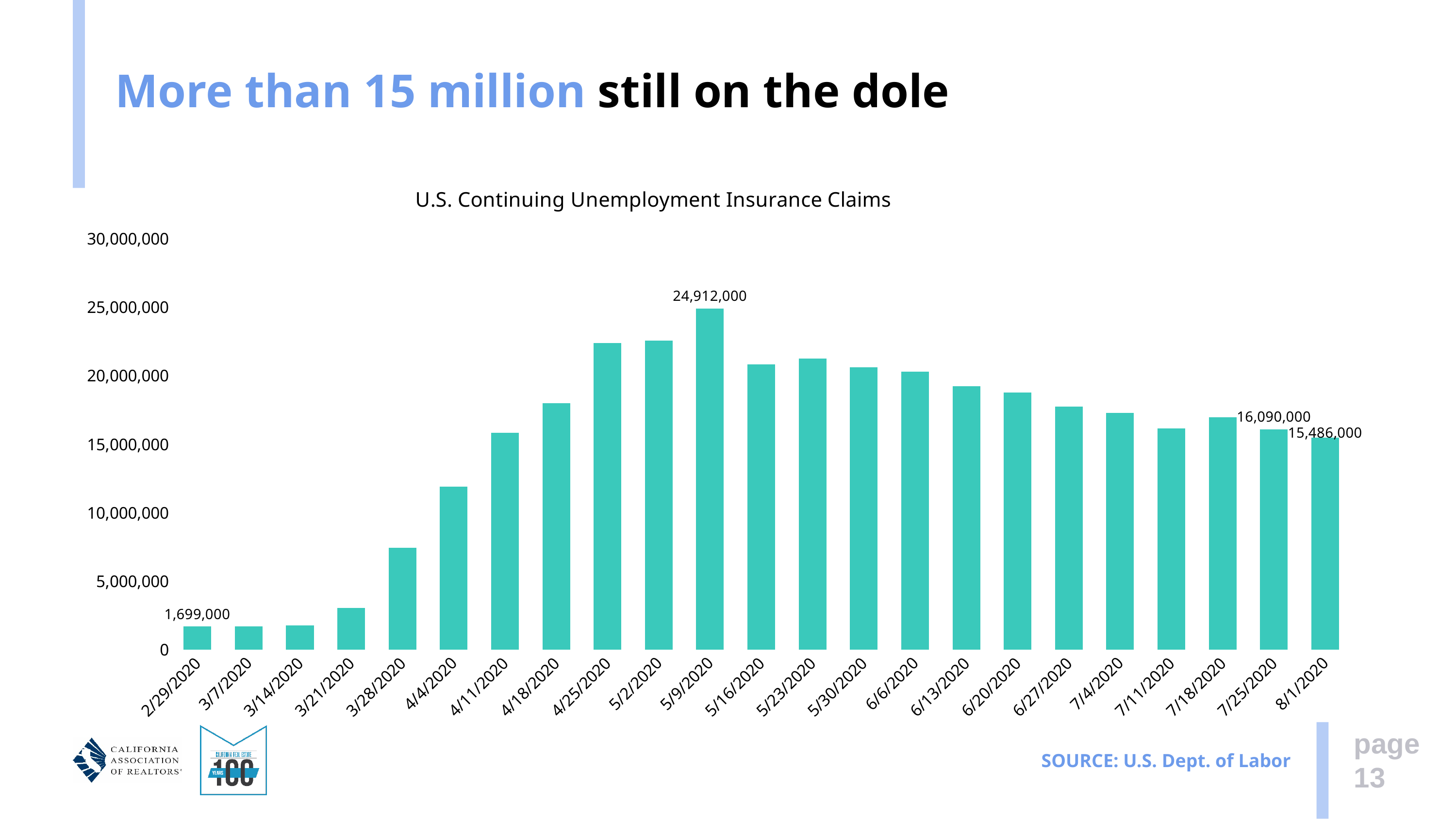
What type of chart is shown on the slide? bar chart What is the value for 5/9/2020? 24,912,000 What is the value for 7/25/2020? 16,090,000 Which is larger, the value for 4/11/2020 or 4/18/2020? 4/18/2020 Which date has the highest value? 5/9/2020 What is the value for 8/1/2020? 15,486,000 What is the difference between the values for 7/25/2020 and 8/1/2020? 604,000 Is the value for 4/4/2020 greater or less than 15,000,000? less What is the title of the chart? U.S. Continuing Unemployment Insurance Claims What is the value for 2/29/2020? 1,699,000 What is the difference between the values for 5/9/2020 and 8/1/2020? 9,426,000 How many dates are shown on the x axis? 23